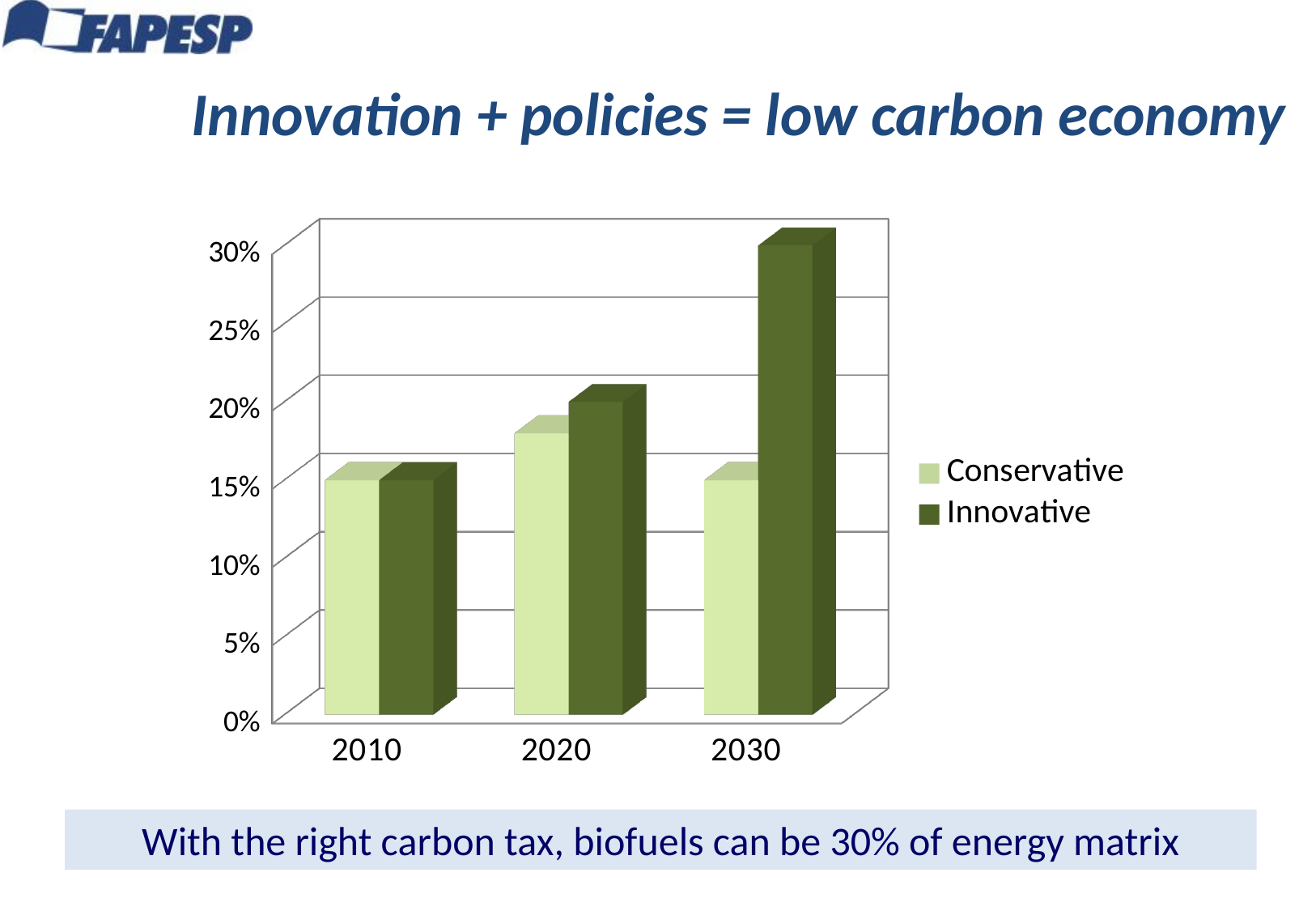
What kind of chart is shown on the slide? bar chart Is the value of the Innovative bar for 2030 greater or less than 25%? greater Is the value of the Conservative bar for 2030 greater or less than 20%? less How many series does the legend list? 2 What is the value of the Innovative bar for 2030? 30% What is the title of the slide above the chart? Innovation + policies = low carbon economy How many years are shown on the x axis? 3 Do the Innovative values rise or fall from 2010 to 2030? rise For 2030, which is larger, the Conservative bar or the Innovative bar? Innovative Is the value of the Innovative bar for 2020 greater or less than 25%? less In which year is the Innovative bar highest? 2030 What are the two series named in the legend? Conservative and Innovative